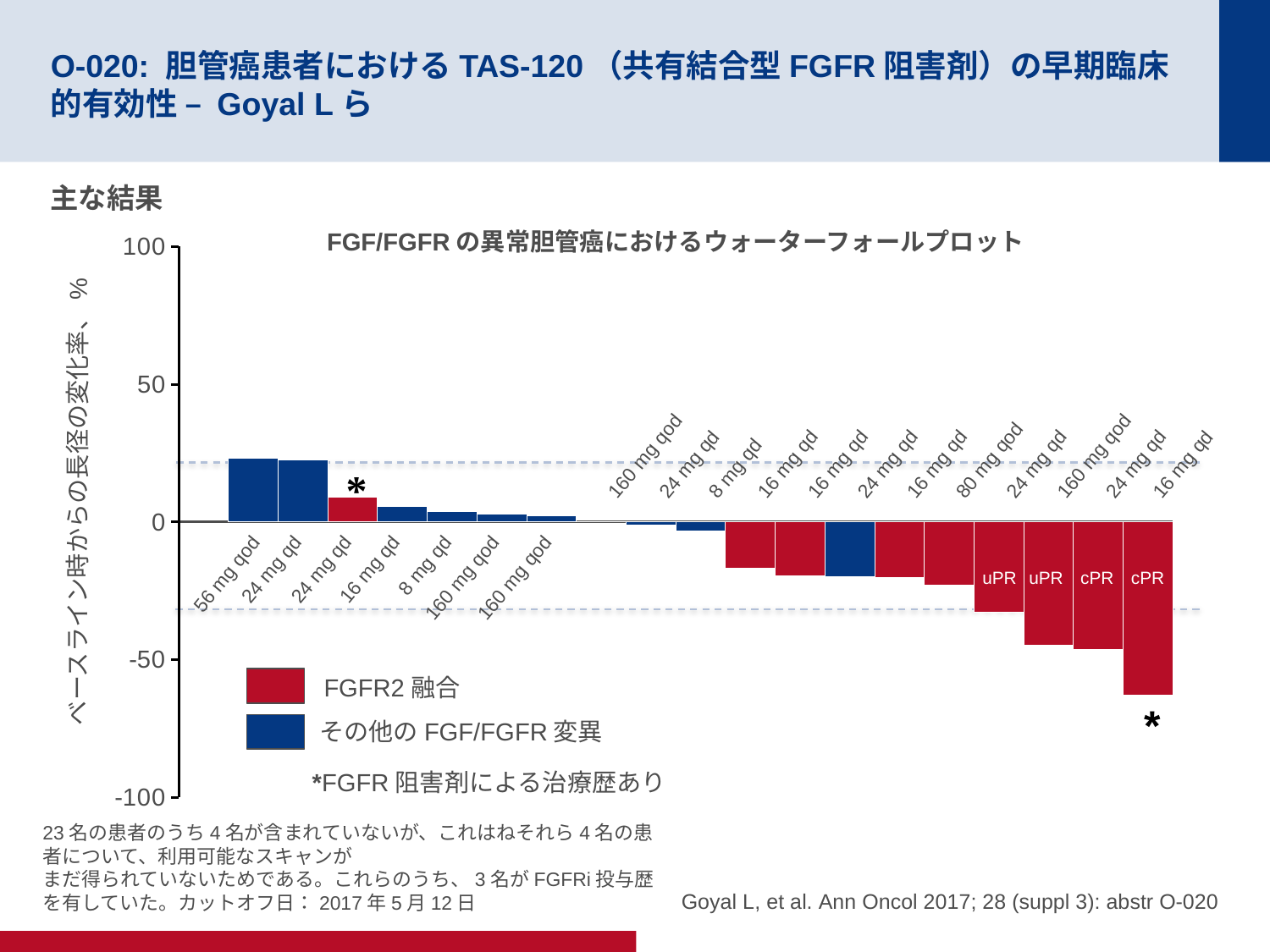
Which colour represents FGFR2 融合 in the legend? Red What is the title of the chart? FGF/FGFR の異常胆管癌におけるウォーターフォールプロット Which bar is lower: the 80 mg qod bar (uPR) or the rightmost 16 mg qd bar (cPR)? The rightmost 16 mg qd bar (cPR) Which bar has the lowest value in the chart? The rightmost bar (16 mg qd, cPR) Is the value for the 56 mg qod bar greater or less than 50? less How many series does the legend list? 2 Is the value for the rightmost bar (16 mg qd, cPR) greater or less than -50? less Do the bar values rise or fall from left to right along the x axis? Fall How many bars are labelled cPR? 2 What kind of chart is shown on the slide? Bar chart (waterfall plot) How many bars (patients) are plotted in the waterfall plot? 19 Is the value for the 80 mg qod bar (uPR) greater or less than -50? greater